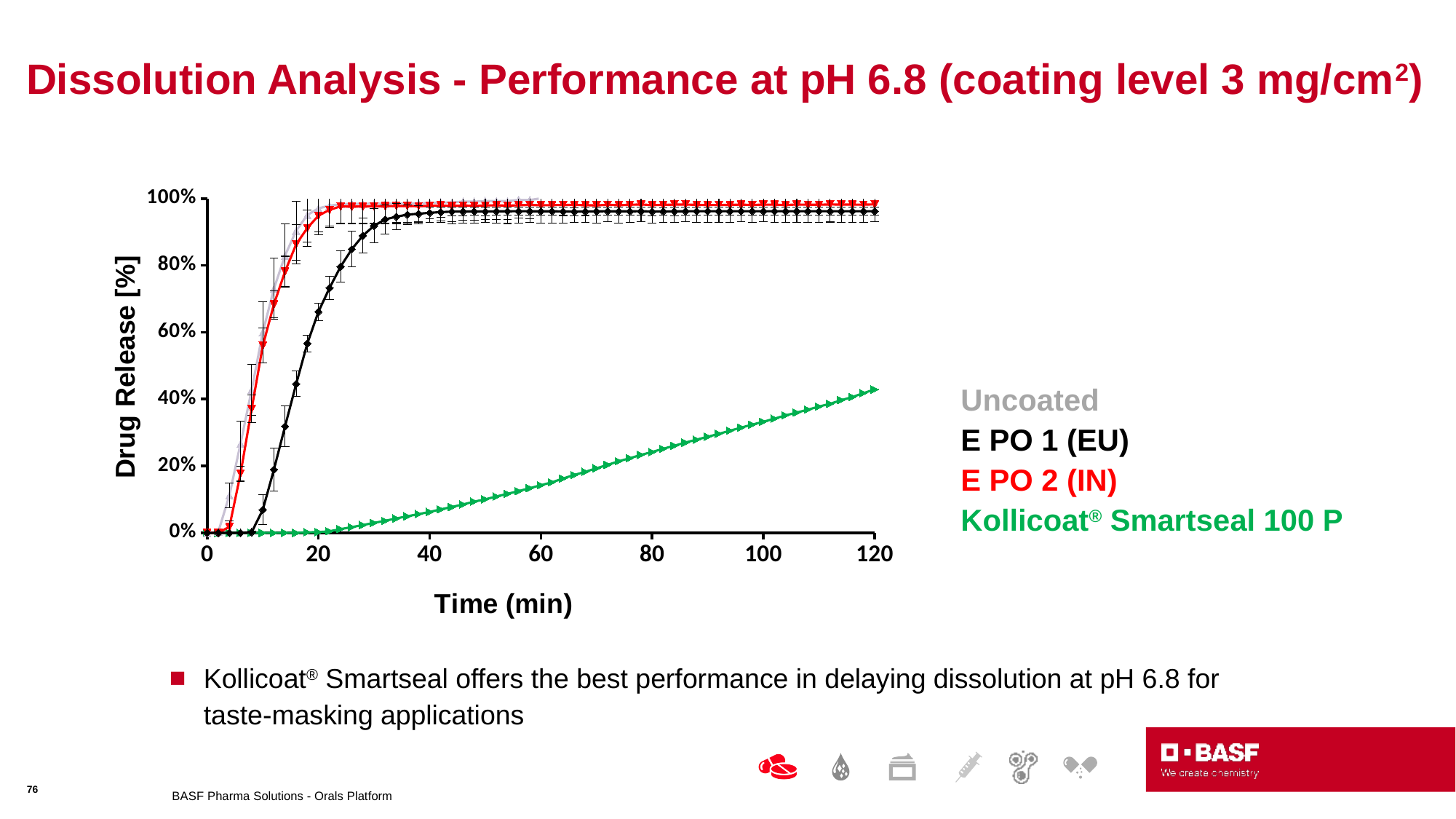
Is the drug release for E PO 1 (EU) at 60 min greater or less than 80%? greater How many series does the legend list? 4 Which series has the lowest drug release at 120 min? Kollicoat Smartseal 100 P What kind of chart is shown on the slide? line chart Is the drug release for Kollicoat Smartseal 100 P at 120 min greater or less than 60%? less Is the drug release for Kollicoat Smartseal 100 P at 60 min greater or less than 20%? less What colour is the line for Kollicoat Smartseal 100 P? green What is the label of the x axis? Time (min) At 20 min, which series has the higher drug release: E PO 1 (EU) or E PO 2 (IN)? E PO 2 (IN) At 60 min, which series has the higher drug release: E PO 1 (EU) or Kollicoat Smartseal 100 P? E PO 1 (EU) Does the drug release for Kollicoat Smartseal 100 P rise or fall as time increases? rises